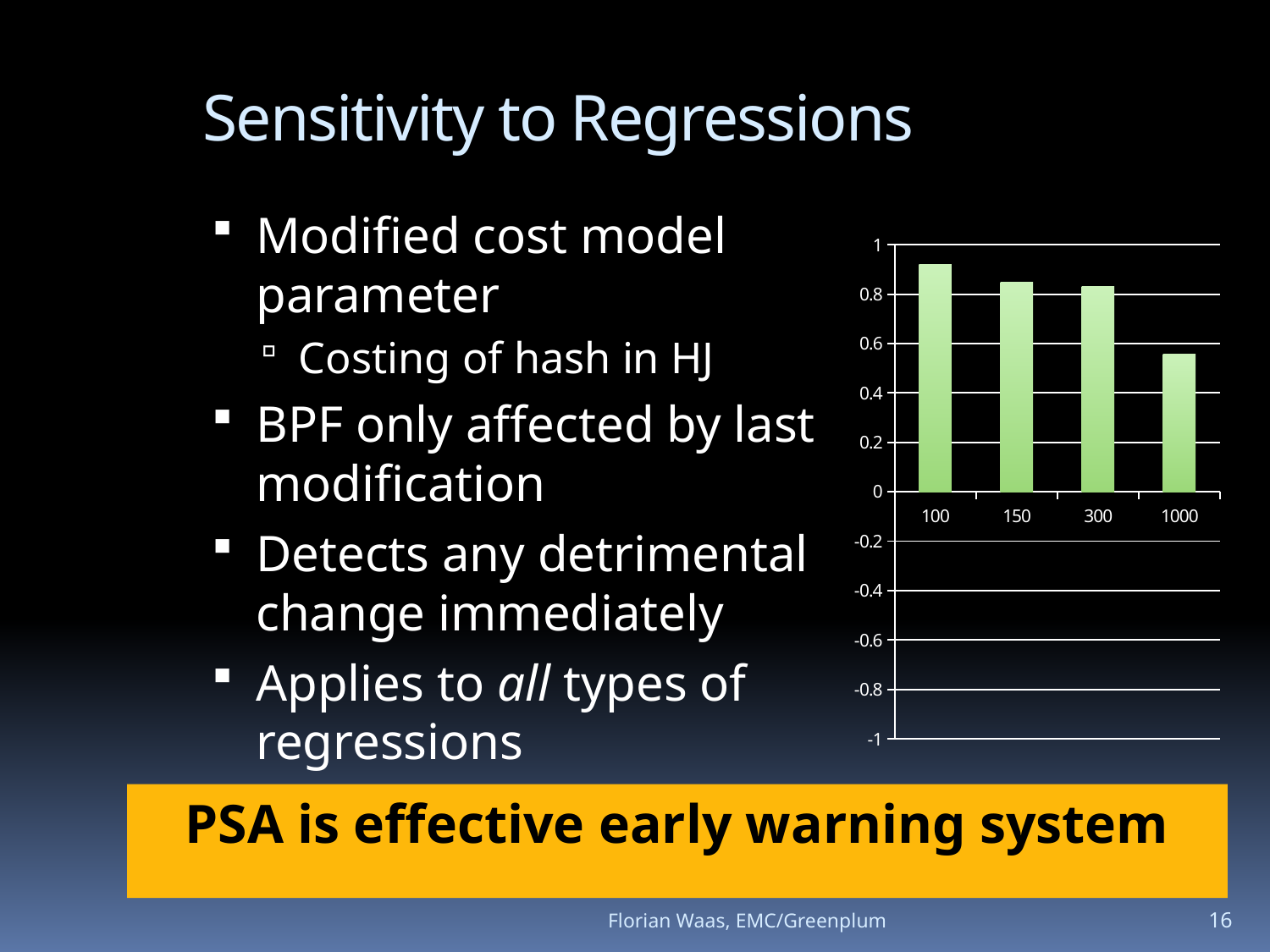
Which is larger, the value for 150 or the value for 1000? 150 What is the lowest value shown on the chart's vertical axis? -1 What kind of chart is shown on the slide? bar chart How many categories are shown on the x axis of the chart? 4 Do the bar values rise or fall as you move from 100 to 1000 along the x axis? fall Which category has the lowest bar in the chart? 1000 Which is larger, the value for 100 or the value for 1000? 100 Is the value for 300 greater or less than 0.6? greater Is the value for 1000 greater or less than 0.4? greater Which category has the highest bar in the chart? 100 Is the value for 100 greater or less than 0.8? greater